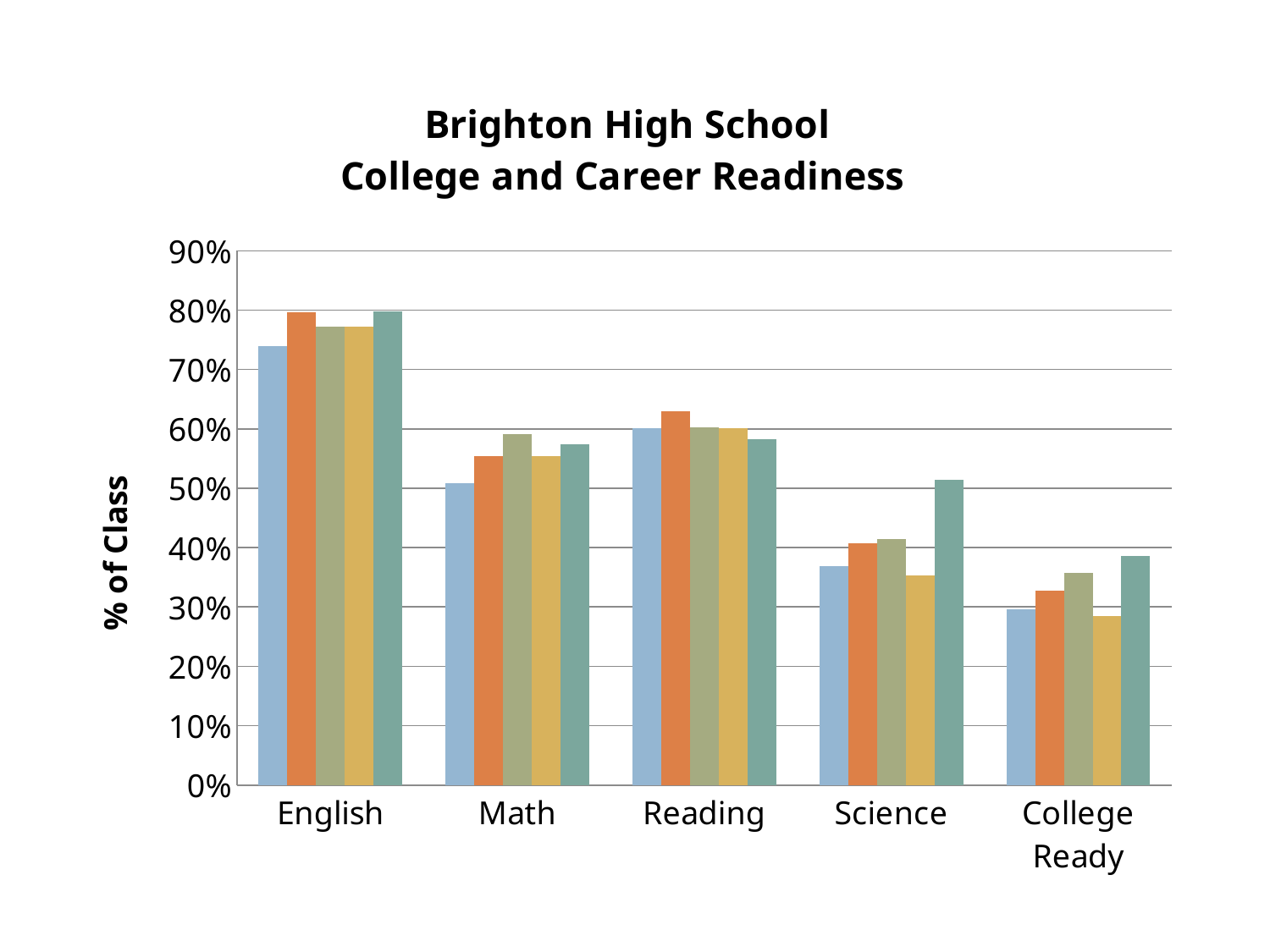
Which category has the highest values overall? English Is the value of the yellow bar for College Ready greater or less than 30%? less Which category has the lowest values overall? College Ready How many categories are shown along the x axis? 5 What kind of chart is shown on the slide? bar chart How many bars are plotted for each category? 5 What is the title of the chart? Brighton High School College and Career Readiness What is the label on the vertical axis? % of Class Is the value of the dark teal bar for Science greater or less than 50%? greater Is the value of the orange bar for English greater or less than 70%? greater Which is larger for Science: the light blue bar or the dark teal bar? dark teal bar